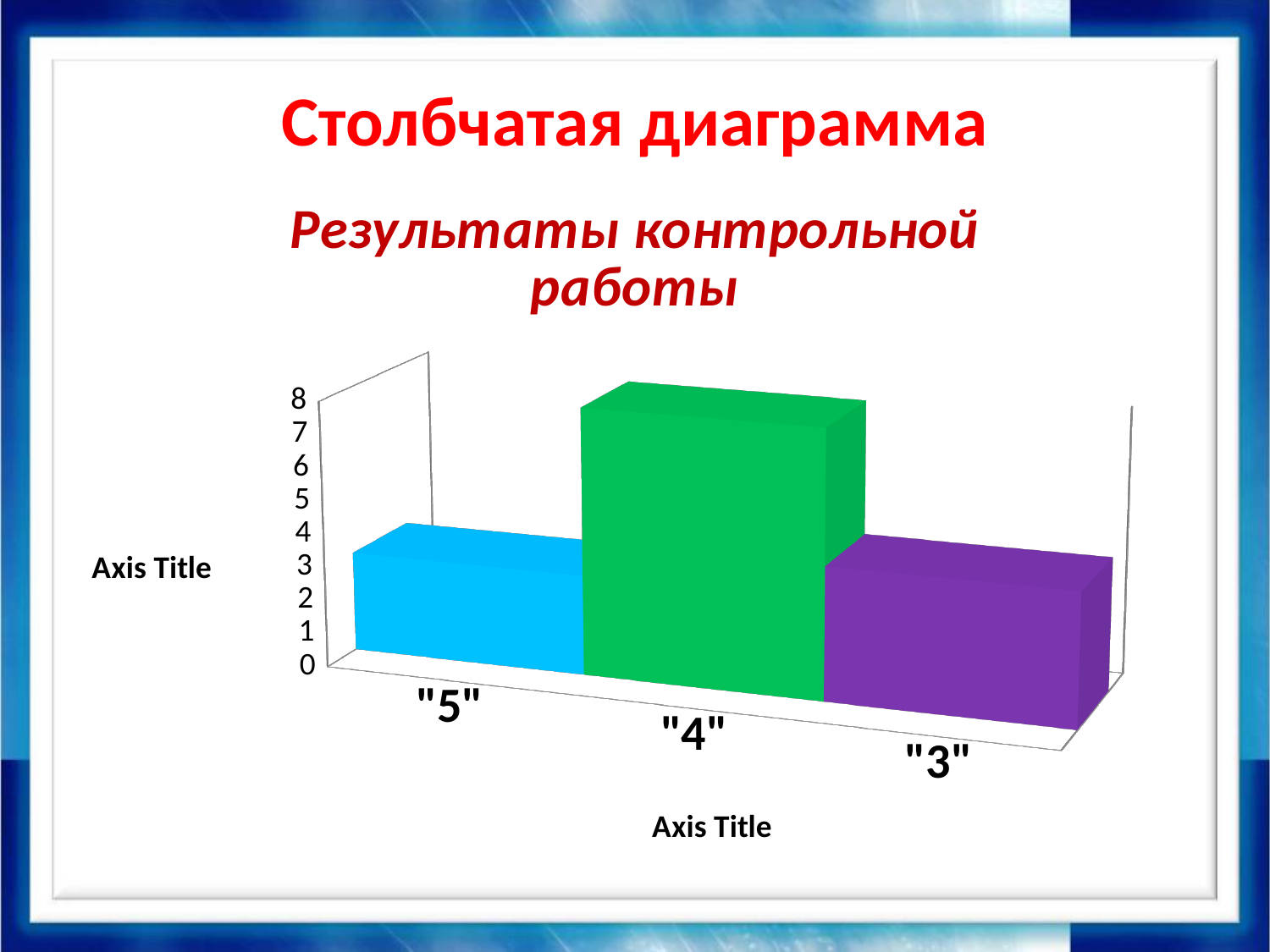
Which is larger, the value for "4" or the value for "5"? "4" What colour is the bar for category "4"? green How many categories are plotted on the chart? 3 Which is larger, the value for "4" or the value for "3"? "4" Is the value for "3" greater or less than 5? less What is the title of the chart? Результаты контрольной работы What kind of chart is shown on the slide? bar chart What is the highest value shown on the vertical axis? 8 Is the value for "5" greater or less than 5? less Which category has the highest bar? "4" Is the value for "4" greater or less than 6? greater